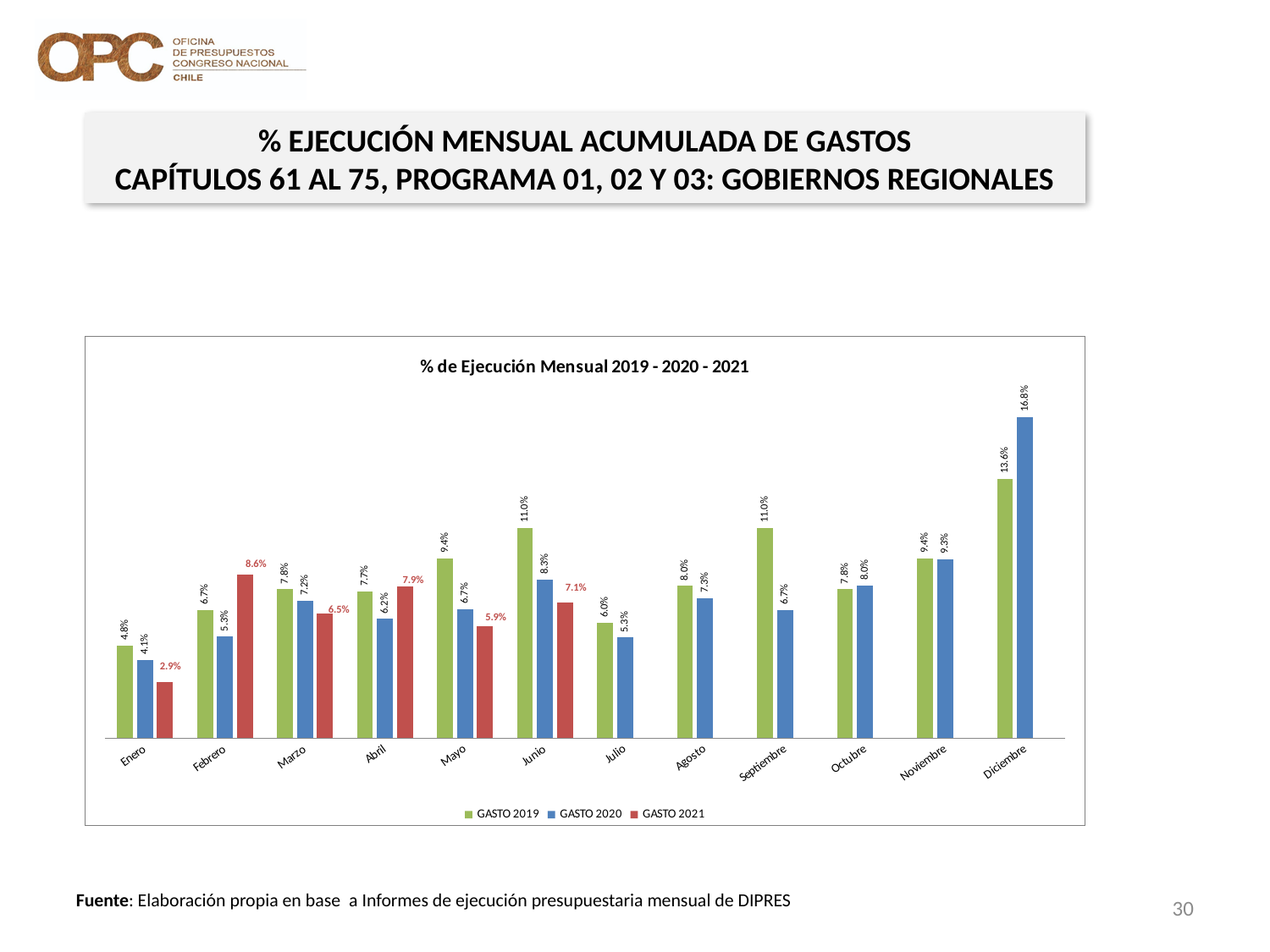
What is the difference between GASTO 2019 and GASTO 2021 in Enero? 1.9 percentage points What is the difference between GASTO 2020 and GASTO 2019 in Diciembre? 3.2 percentage points How many months are shown on the x axis? 12 What is the value for GASTO 2019 in Junio? 11.0% What type of chart is shown? Bar chart In Mayo, which is larger: GASTO 2019 or GASTO 2020? GASTO 2019 In which month is GASTO 2021 lowest? Enero How many months have a GASTO 2021 bar? 6 What is the value for GASTO 2021 in Febrero? 8.6% How many series does the legend list? 3 In which month is GASTO 2019 highest? Diciembre What is the value for GASTO 2020 in Diciembre? 16.8%